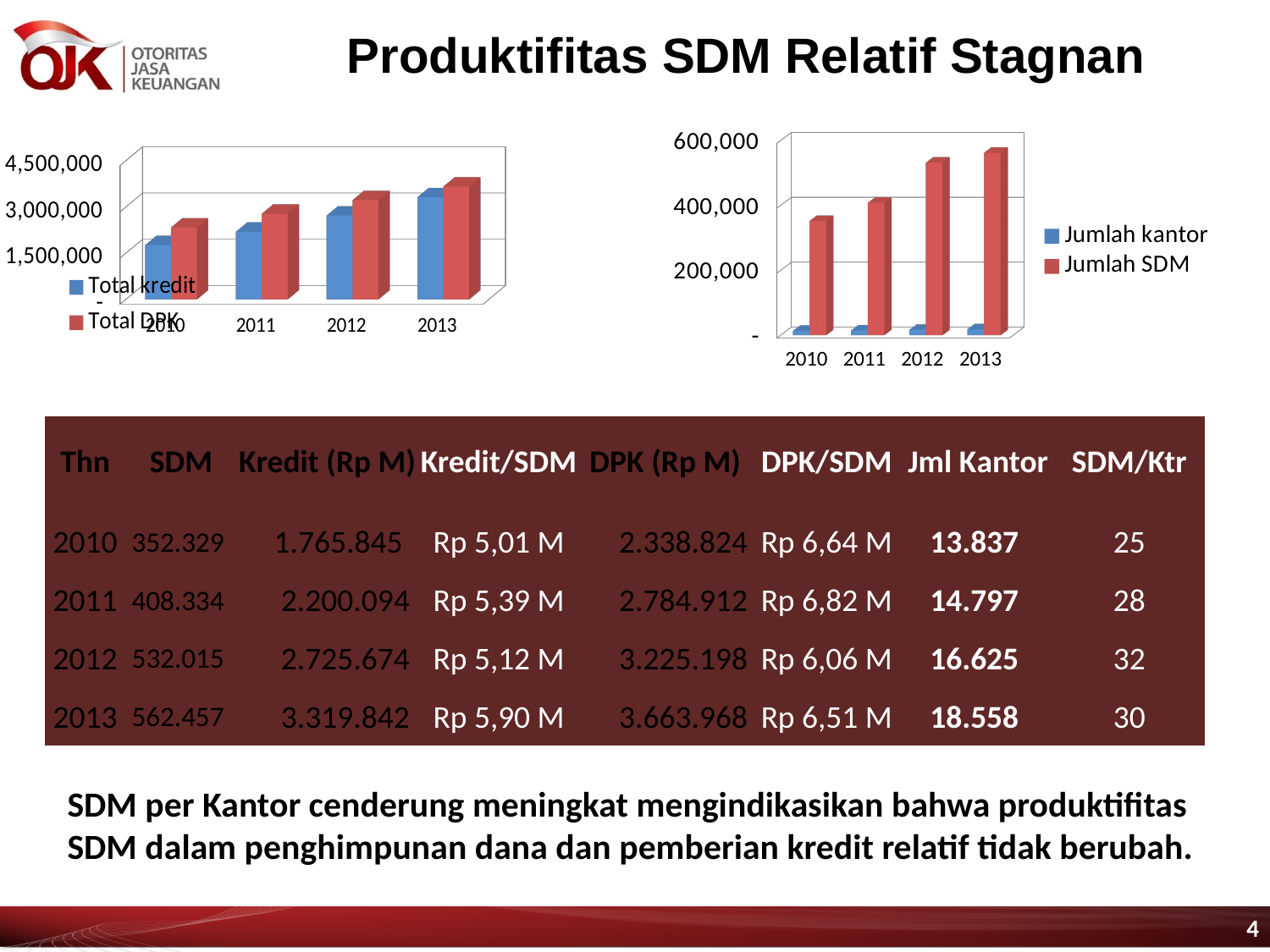
In the left chart, is the value for Total DPK in 2013 greater or less than 3,000,000? greater In the right chart, is the value for Jumlah SDM in 2010 greater or less than 400,000? less In the left chart, is Total DPK or Total kredit larger in 2010? Total DPK In the right chart, is the value for Jumlah SDM in 2012 greater or less than 400,000? greater How many years are shown on the x axis of the left chart? 4 In the left chart, do the Total kredit values rise or fall from 2010 to 2013? rise In the right chart, is Jumlah SDM or Jumlah kantor larger in 2013? Jumlah SDM How many series does the legend of the right chart list? 2 What kind of chart is the left chart (Total kredit / Total DPK)? bar chart What are the two legend entries of the right chart? Jumlah kantor, Jumlah SDM In the right chart, which year has the highest Jumlah SDM? 2013 In the left chart, which year has the lowest Total kredit? 2010